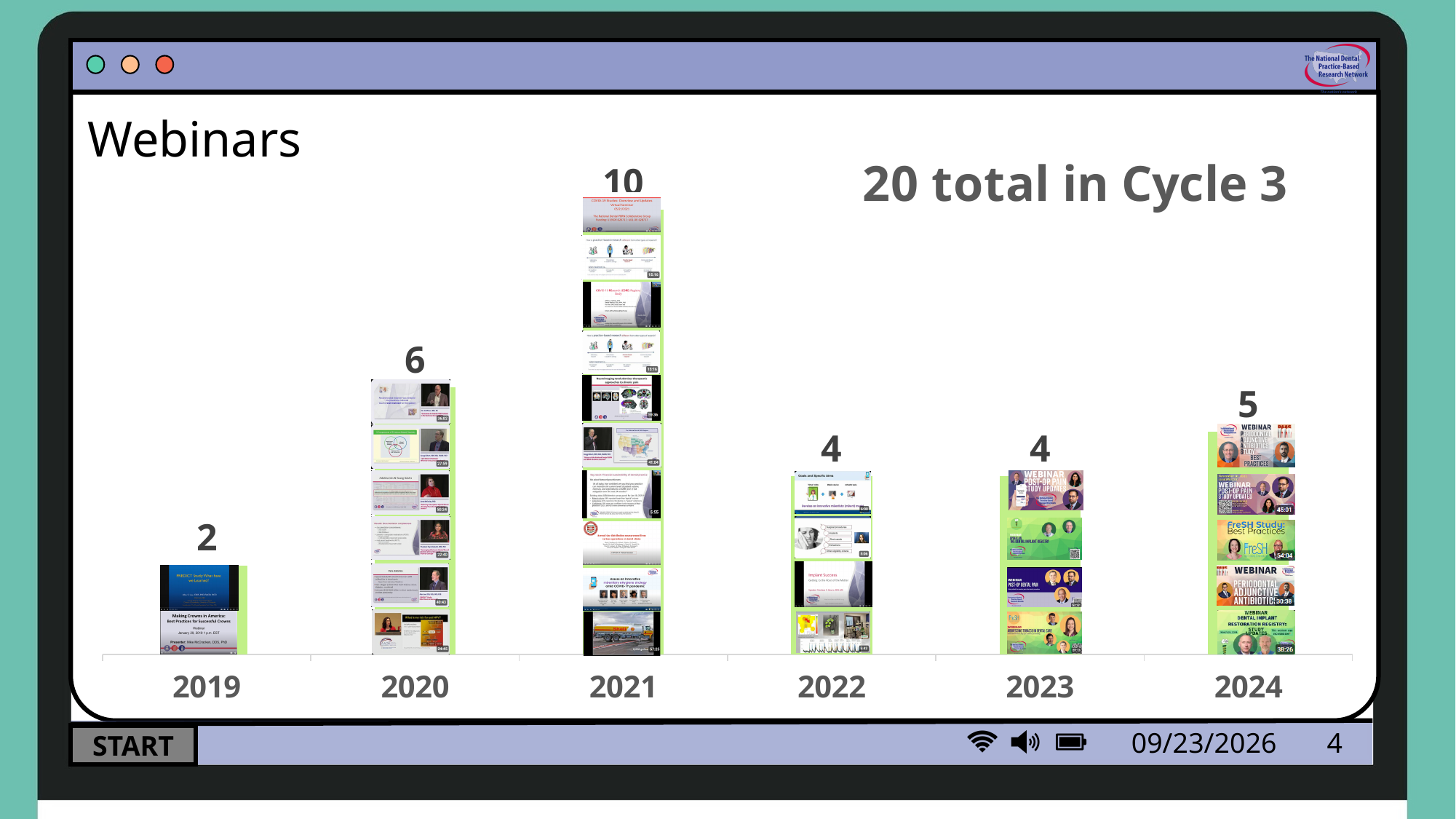
What is the value for 2019? 2 Which is larger, the value for 2020 or the value for 2024? 2020 How many webinars are shown for 2021? 10 Do the values rise or fall from 2021 to 2022? fall What kind of chart is this? bar chart What is the difference between the values for 2021 and 2020? 4 How many webinars are shown for 2024? 5 What is the title of the chart? 20 total in Cycle 3 Which year has the lowest number of webinars? 2019 What is the difference between the values for 2024 and 2019? 3 How many years are shown on the x axis? 6 Which year has the highest number of webinars? 2021